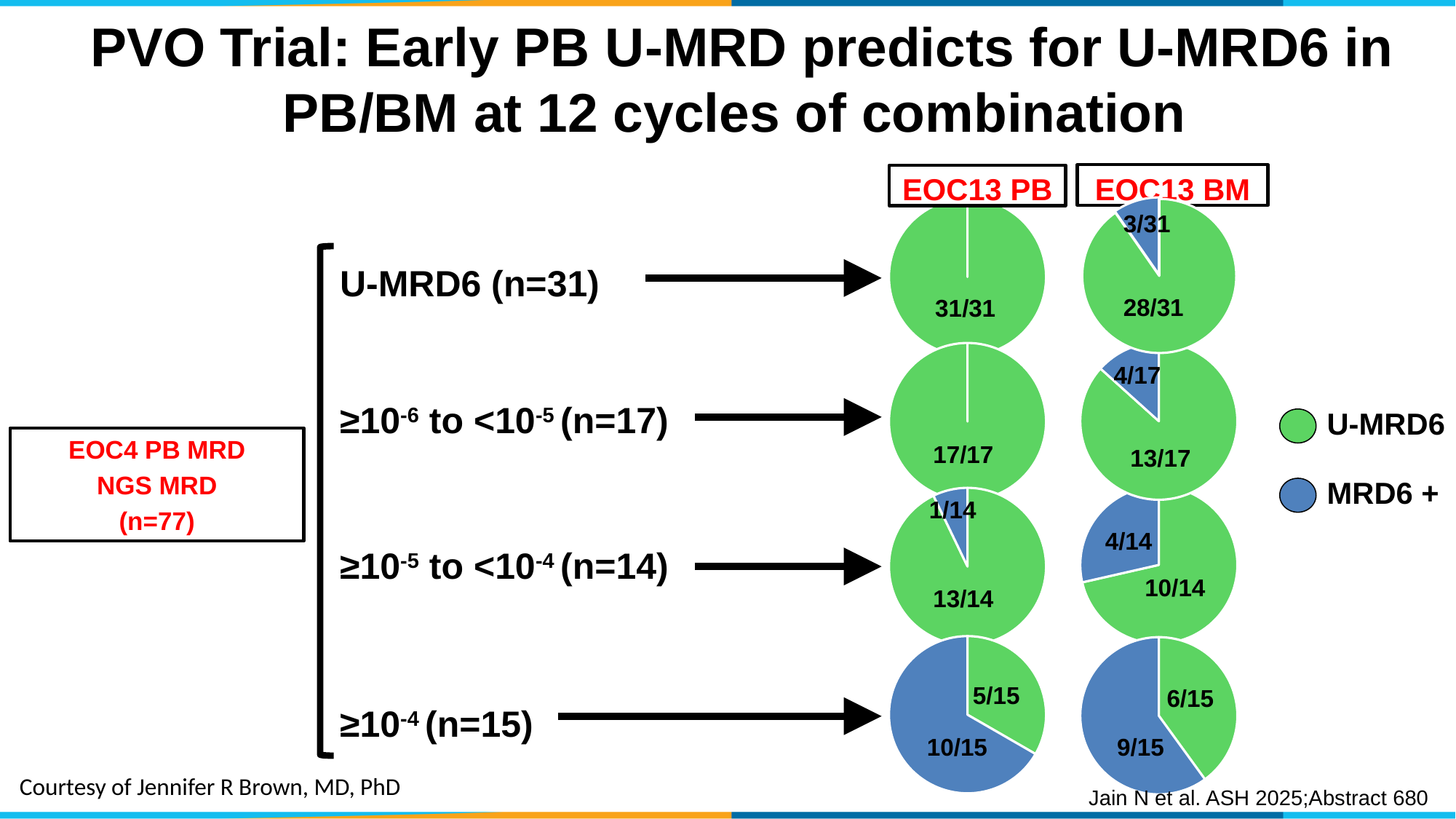
In the EOC13 BM pie chart for the U-MRD6 (n=31) group, what fraction is labelled as MRD6 +? 3/31 Which colour represents MRD6 + in the pie charts? Blue In the EOC13 BM pie chart for the ≥10^-5 to <10^-4 (n=14) group, which slice is larger, U-MRD6 or MRD6 +? U-MRD6 In the EOC13 PB pie chart for the U-MRD6 (n=31) group, what fraction is labelled as U-MRD6? 31/31 How many categories does the legend list for the pie charts? 2 In the EOC13 PB pie chart for the ≥10^-5 to <10^-4 (n=14) group, what fraction is labelled as MRD6 +? 1/14 In the EOC13 BM pie chart for the ≥10^-5 to <10^-4 (n=14) group, what fraction is labelled as U-MRD6? 10/14 In the EOC13 BM pie chart for the ≥10^-4 (n=15) group, what fraction is labelled as U-MRD6? 6/15 In the EOC13 PB pie chart for the ≥10^-4 (n=15) group, which slice is larger, U-MRD6 or MRD6 +? MRD6 + In the EOC13 PB pie chart for the ≥10^-4 (n=15) group, what fraction is labelled as MRD6 +? 10/15 In the EOC13 BM pie chart for the ≥10^-6 to <10^-5 (n=17) group, what fraction is labelled as U-MRD6? 13/17 What kind of chart is used to show the EOC13 PB and EOC13 BM results? Pie chart